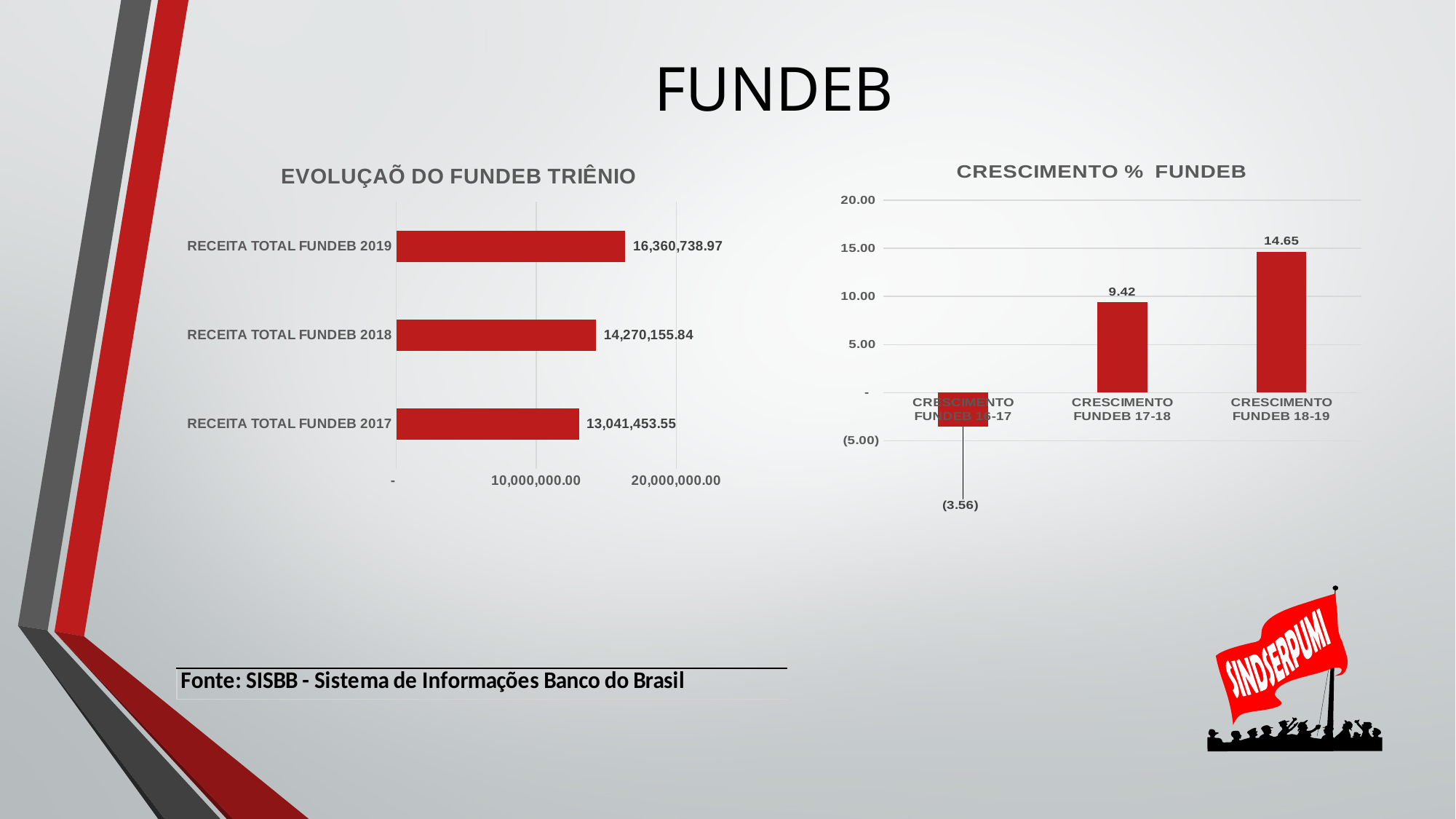
In the 'CRESCIMENTO % FUNDEB' chart, what is the value for CRESCIMENTO FUNDEB 16-17? (3.56) In the 'EVOLUÇAÕ DO FUNDEB TRIÊNIO' chart, what is the difference between the 2019 and 2018 values? 2,090,583.13 In the 'CRESCIMENTO % FUNDEB' chart, what is the difference between the 18-19 and 17-18 values? 5.23 In the 'CRESCIMENTO % FUNDEB' chart, which category has the highest value? CRESCIMENTO FUNDEB 18-19 What kind of chart is 'EVOLUÇAÕ DO FUNDEB TRIÊNIO'? Bar chart In the 'CRESCIMENTO % FUNDEB' chart, what is the value for CRESCIMENTO FUNDEB 17-18? 9.42 In the 'EVOLUÇAÕ DO FUNDEB TRIÊNIO' chart, what is the value for RECEITA TOTAL FUNDEB 2019? 16,360,738.97 In the 'CRESCIMENTO % FUNDEB' chart, do the values rise or fall from left to right? Rise In the 'EVOLUÇAÕ DO FUNDEB TRIÊNIO' chart, what is the value for RECEITA TOTAL FUNDEB 2017? 13,041,453.55 In the 'CRESCIMENTO % FUNDEB' chart, is the value for CRESCIMENTO FUNDEB 18-19 greater or less than 10.00? greater In the 'EVOLUÇAÕ DO FUNDEB TRIÊNIO' chart, which category has the lowest value? RECEITA TOTAL FUNDEB 2017 In the 'EVOLUÇAÕ DO FUNDEB TRIÊNIO' chart, how many bars are plotted? 3